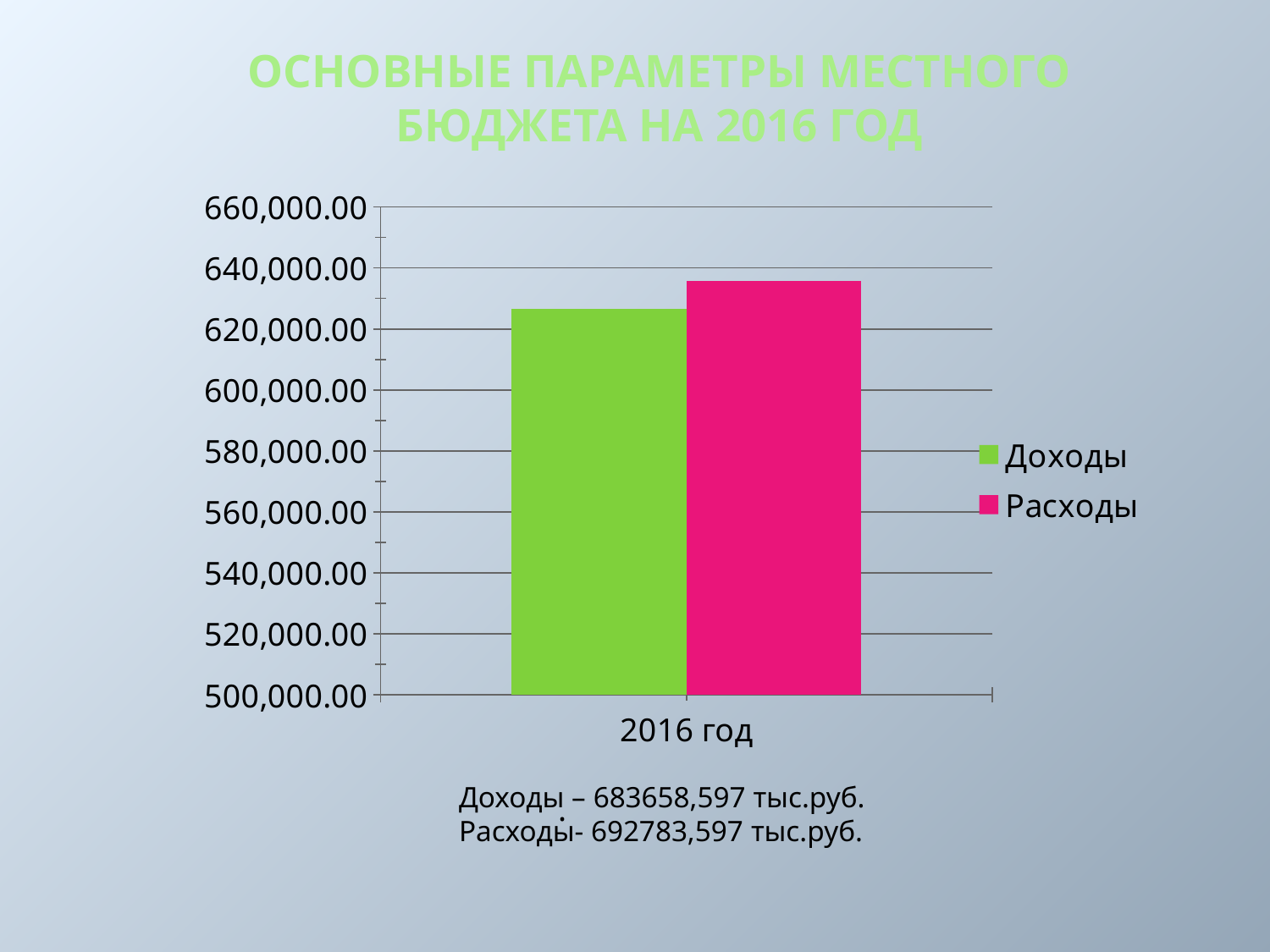
How many categories are shown on the x axis? 1 What are the two series named in the legend? Доходы, Расходы How many series does the legend list? 2 Which series has the lowest bar? Доходы What kind of chart is shown on the slide? bar chart Is the value for Расходы greater or less than 640,000.00? less Is the value for Доходы greater or less than 620,000.00? greater Which series has the highest bar? Расходы Which is larger, the bar for Доходы or the bar for Расходы? Расходы Is the value for Расходы greater or less than 620,000.00? greater What is the category label on the x axis? 2016 год